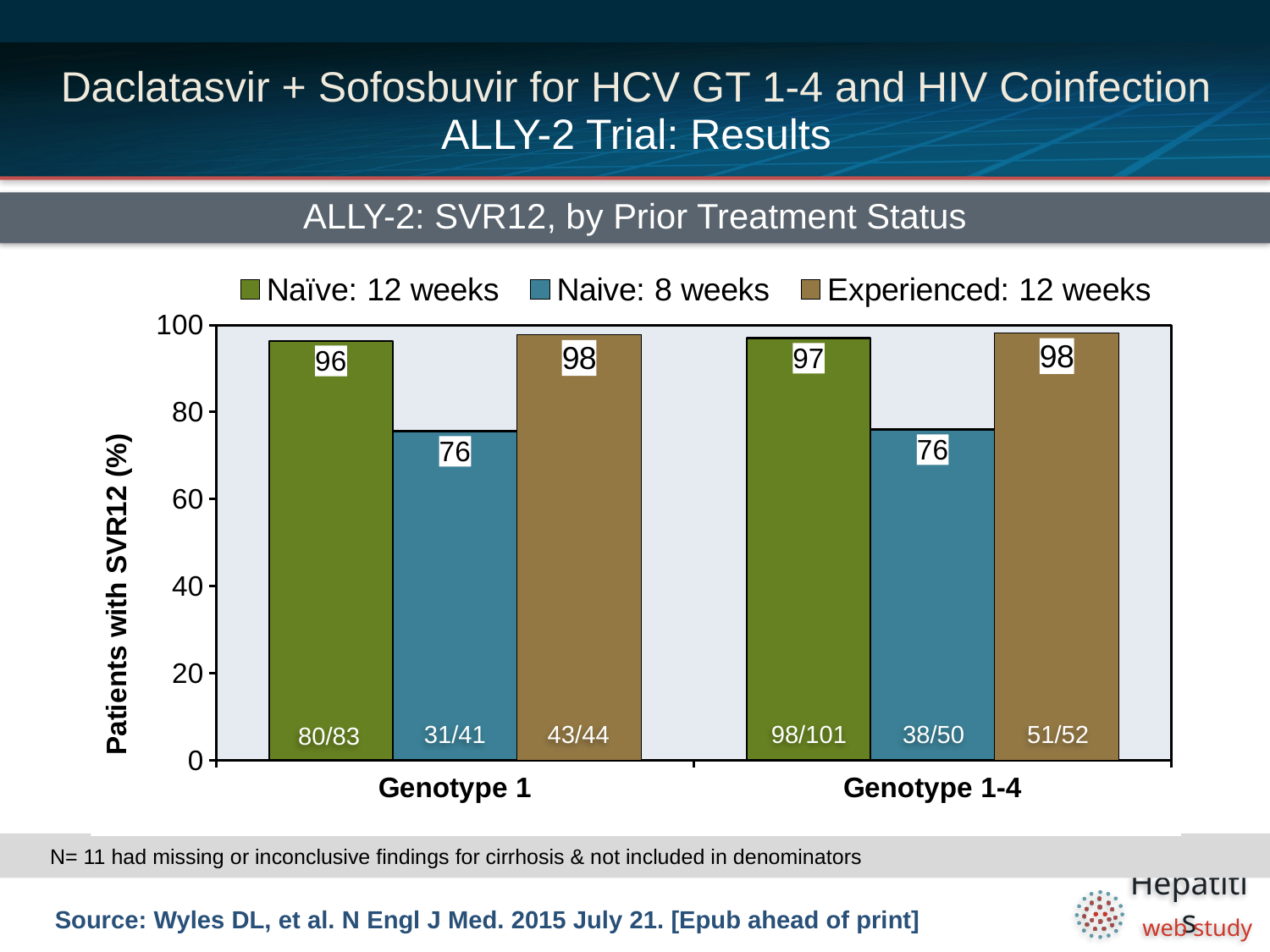
Is the value for Naive: 8 weeks in Genotype 1 greater or less than 80? less What kind of chart is shown on the slide? Bar chart Which is larger in Genotype 1-4: the Naïve: 12 weeks rate or the Naive: 8 weeks rate? Naïve: 12 weeks What is the SVR12 rate for Naive: 8 weeks in Genotype 1-4? 76 What is the difference between the Naïve: 12 weeks and Naive: 8 weeks SVR12 rates in Genotype 1? 20 What fraction of patients is shown for Naïve: 12 weeks in Genotype 1-4? 98/101 What is the SVR12 rate for Naïve: 12 weeks in Genotype 1? 96 What is the title of the chart? ALLY-2: SVR12, by Prior Treatment Status Which series has the lowest SVR12 rate in Genotype 1? Naive: 8 weeks Which series has the highest SVR12 rate in Genotype 1-4? Experienced: 12 weeks What is the SVR12 rate for Experienced: 12 weeks in Genotype 1? 98 How many series does the legend list? 3